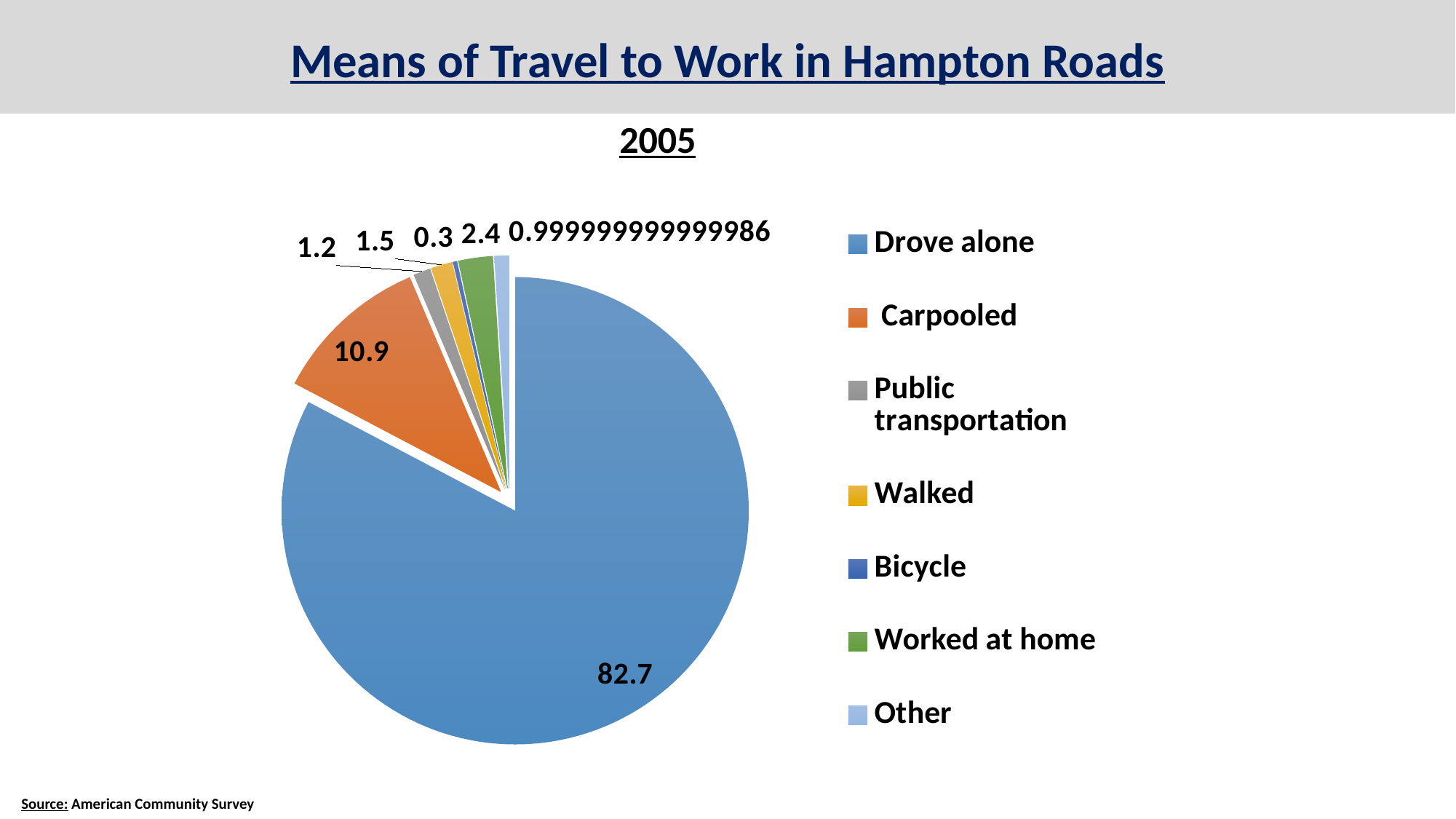
What kind of chart is shown on the slide? pie chart What is the value shown for Drove alone? 82.7 Which category has the smallest slice of the pie? Bicycle What is the difference between the values for Drove alone and Carpooled? 71.8 What is the value shown for Worked at home? 2.4 Which category has the largest slice of the pie? Drove alone What is the value shown for Public transportation? 1.2 Which is larger, the value for Worked at home or the value for Walked? Worked at home How many categories does the legend list? 7 What is the value shown for Carpooled? 10.9 What is the value shown for Bicycle? 0.3 What is the value shown for Walked? 1.5